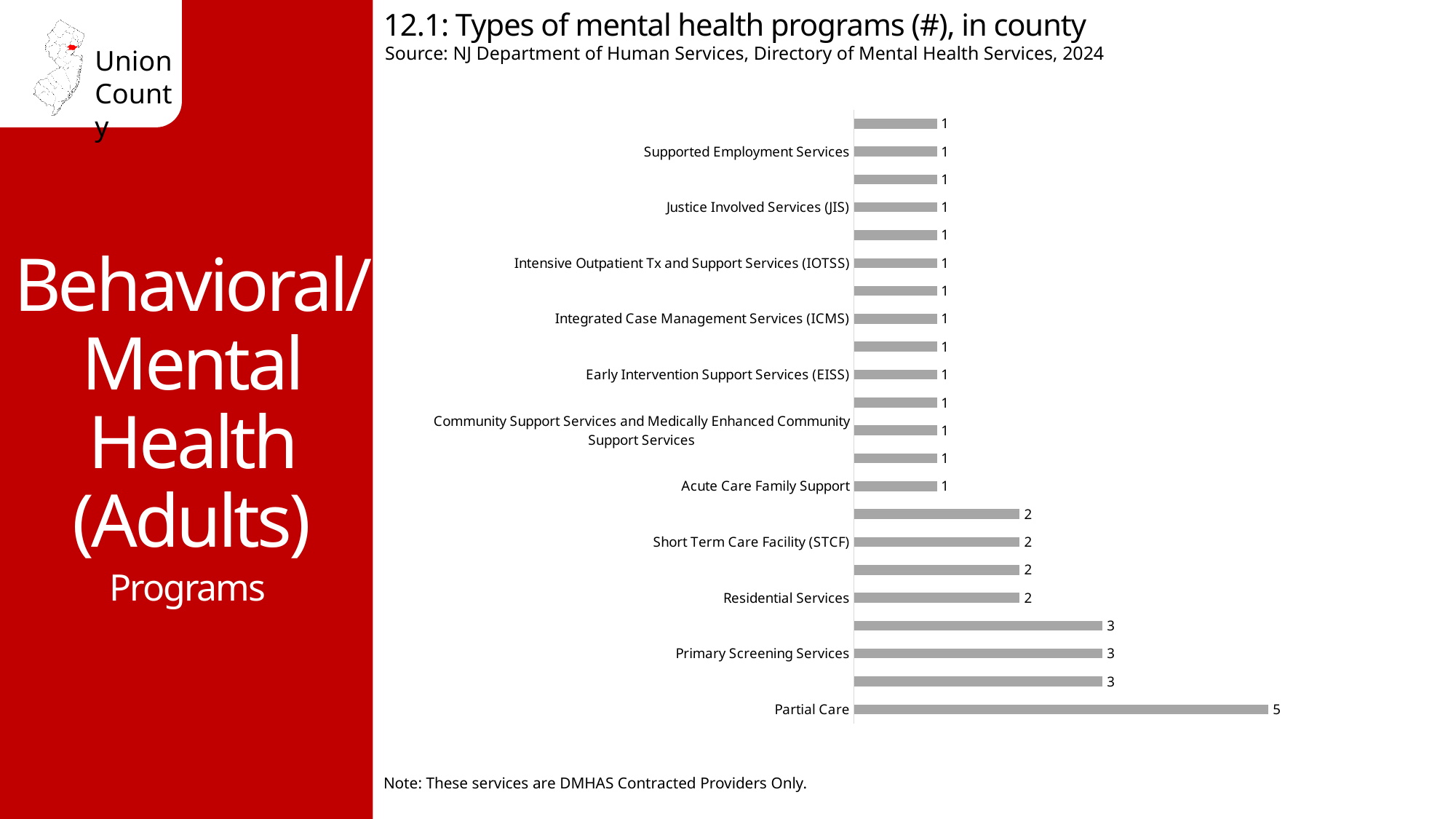
How many bars are plotted in the chart? 22 Which has a larger value, Residential Services or Partial Care? Partial Care What type of chart is shown on the slide? bar chart What is the difference between the values for Partial Care and Primary Screening Services? 2 What is the value for Justice Involved Services (JIS)? 1 Which program type has the highest number of programs? Partial Care What is the value for Primary Screening Services? 3 How many Partial Care programs are shown in the chart? 5 What is the value for Residential Services? 2 What is the title of the chart? 12.1: Types of mental health programs (#), in county What is the value for Acute Care Family Support? 1 What is the value for Short Term Care Facility (STCF)? 2